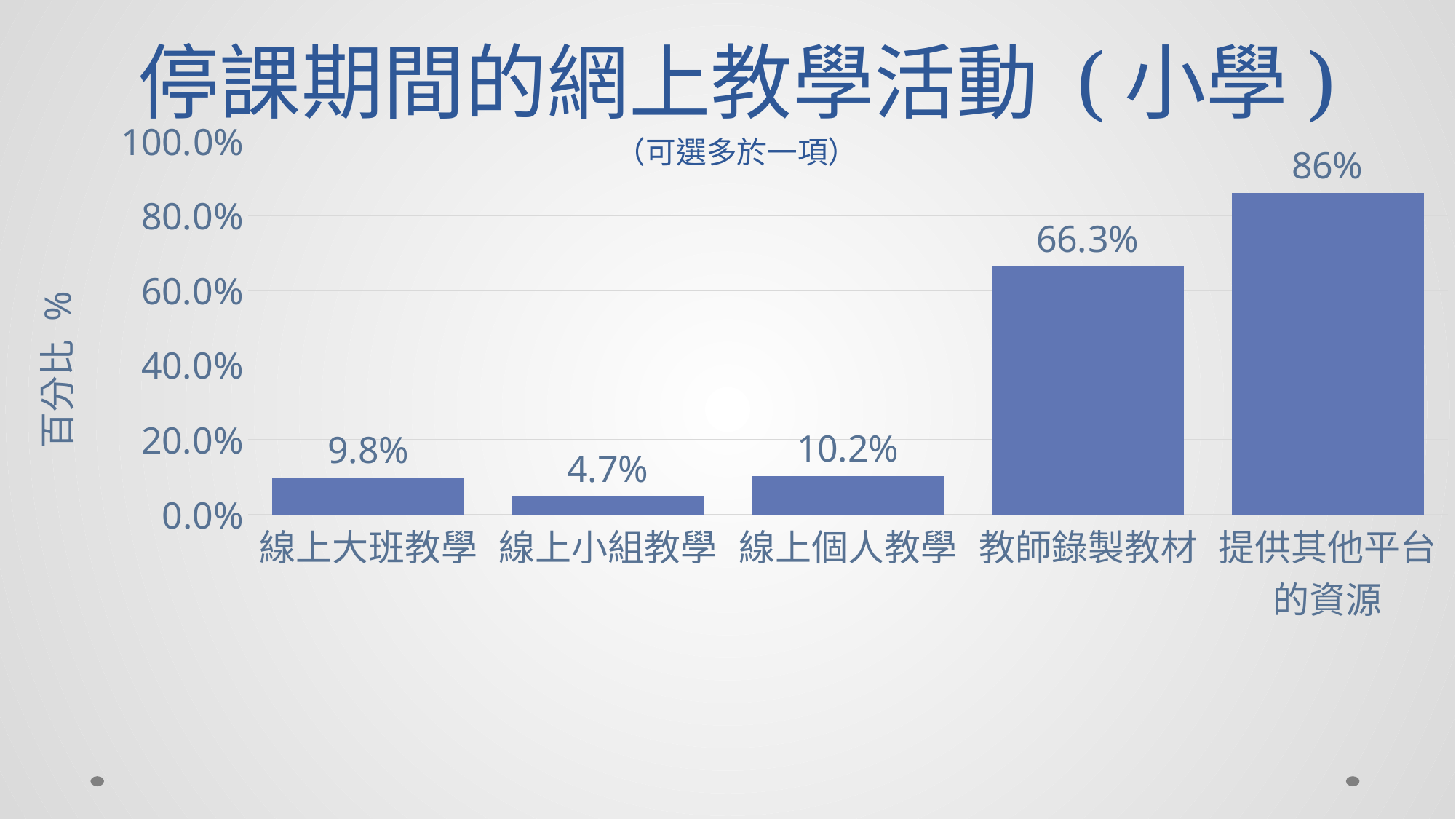
What is the value for 提供其他平台的資源? 86% What is the value for 教師錄製教材? 66.3% What is the difference between the values for 提供其他平台的資源 and 教師錄製教材? 19.7% Which category has the highest value? 提供其他平台的資源 How many categories are shown on the x axis? 5 Is the value for 教師錄製教材 greater or less than 60.0%? greater What kind of chart is shown on the slide? bar chart Which is larger, the value for 線上大班教學 or 線上小組教學? 線上大班教學 Which category has the lowest value? 線上小組教學 What is the value for 線上小組教學? 4.7% What is the value for 線上大班教學? 9.8% What is the value for 線上個人教學? 10.2%